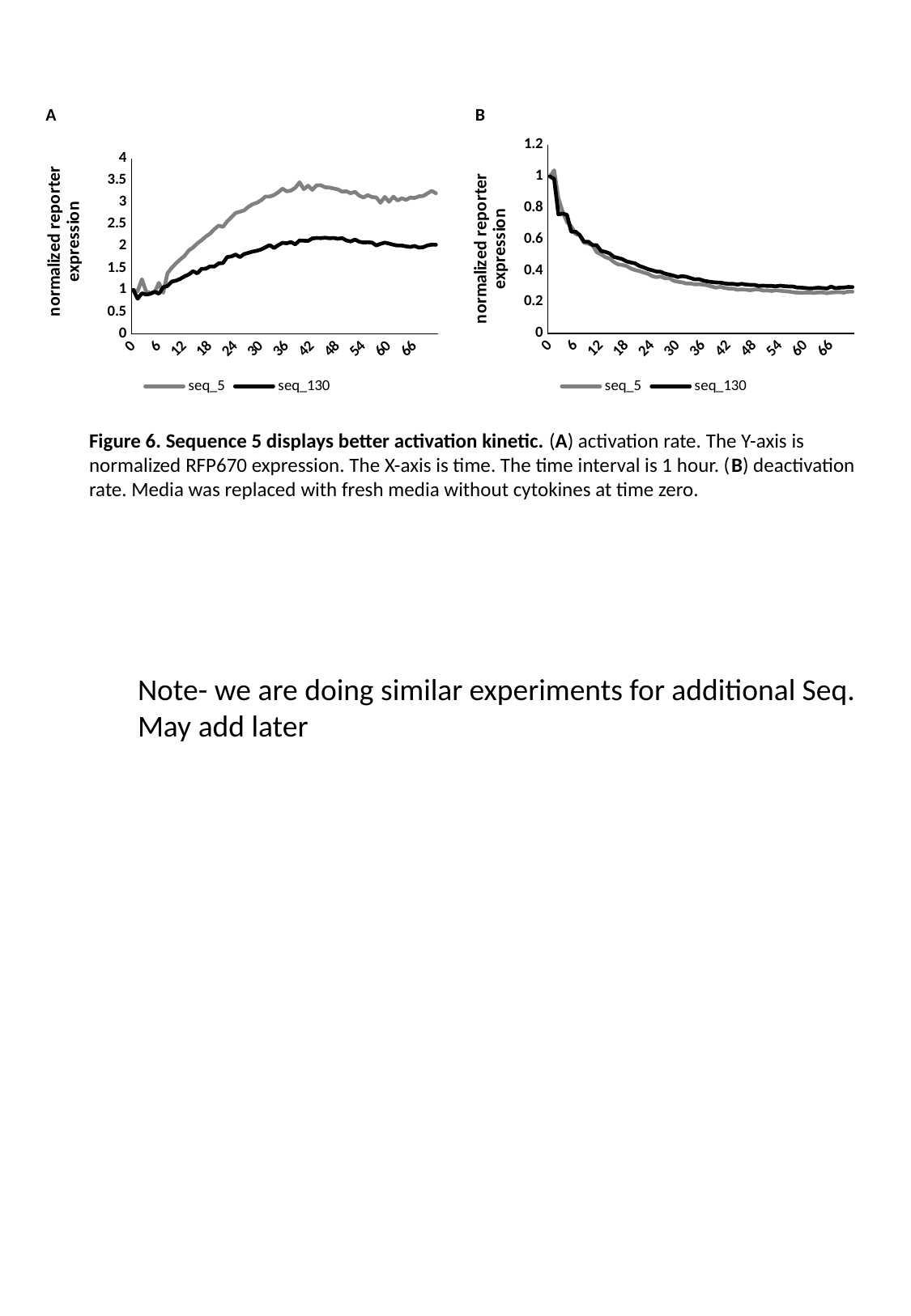
In chart A (the left chart), which series is drawn in black? seq_130 In chart A (the left chart), does the seq_5 series rise or fall between time 0 and time 36? rise How many series does the legend of chart B (the right chart) list? 2 In chart A (the left chart), is the value for seq_5 at time 24 greater or less than 2? greater In chart A (the left chart), is the value for seq_5 at time 36 greater or less than 3? greater In chart B (the right chart), is the value for seq_5 at time 30 greater or less than 0.4? less In chart A (the left chart), which series has the larger value at time 36, seq_5 or seq_130? seq_5 What is the y-axis title of chart B (the right chart)? normalized reporter expression What kind of chart is chart A (the left chart)? line chart In chart B (the right chart), do the values for seq_130 rise or fall between time 0 and time 30? fall